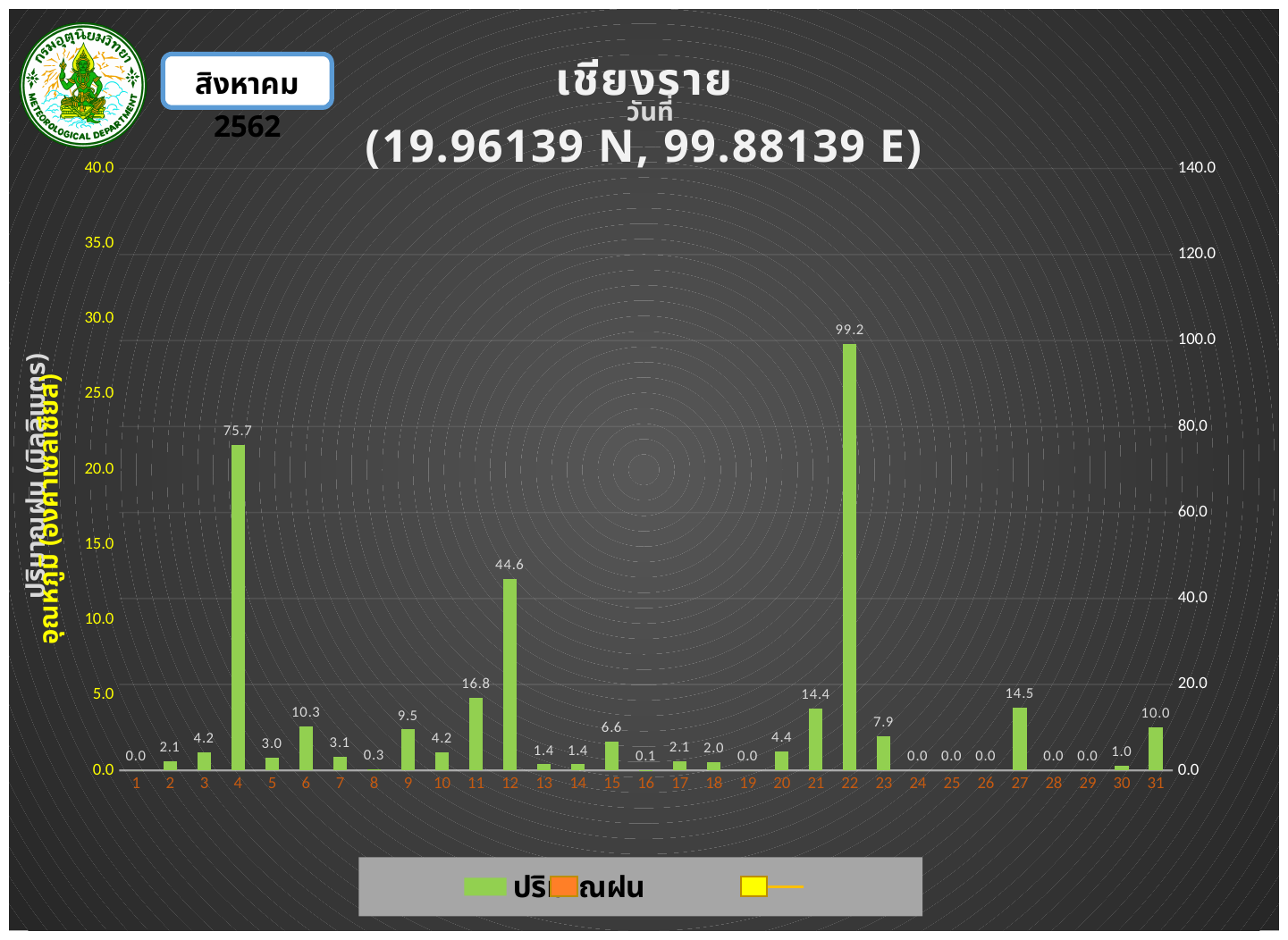
What is the rainfall value shown for day 22? 99.2 What is the rainfall value shown for day 4? 75.7 What is the difference between the rainfall values for day 12 and day 11? 27.8 Which day has the highest rainfall value? 22 How many days show a rainfall value of 0.0? 7 What is the rainfall value shown for day 27? 14.5 What is the difference between the rainfall values for day 22 and day 4? 23.5 Which has a larger rainfall value, day 11 or day 21? day 11 How many days are shown on the x axis? 31 What is the rainfall value shown for day 12? 44.6 What kind of chart is shown on the slide? bar chart Is the value for day 22 greater or less than 80.0 on the right axis? greater